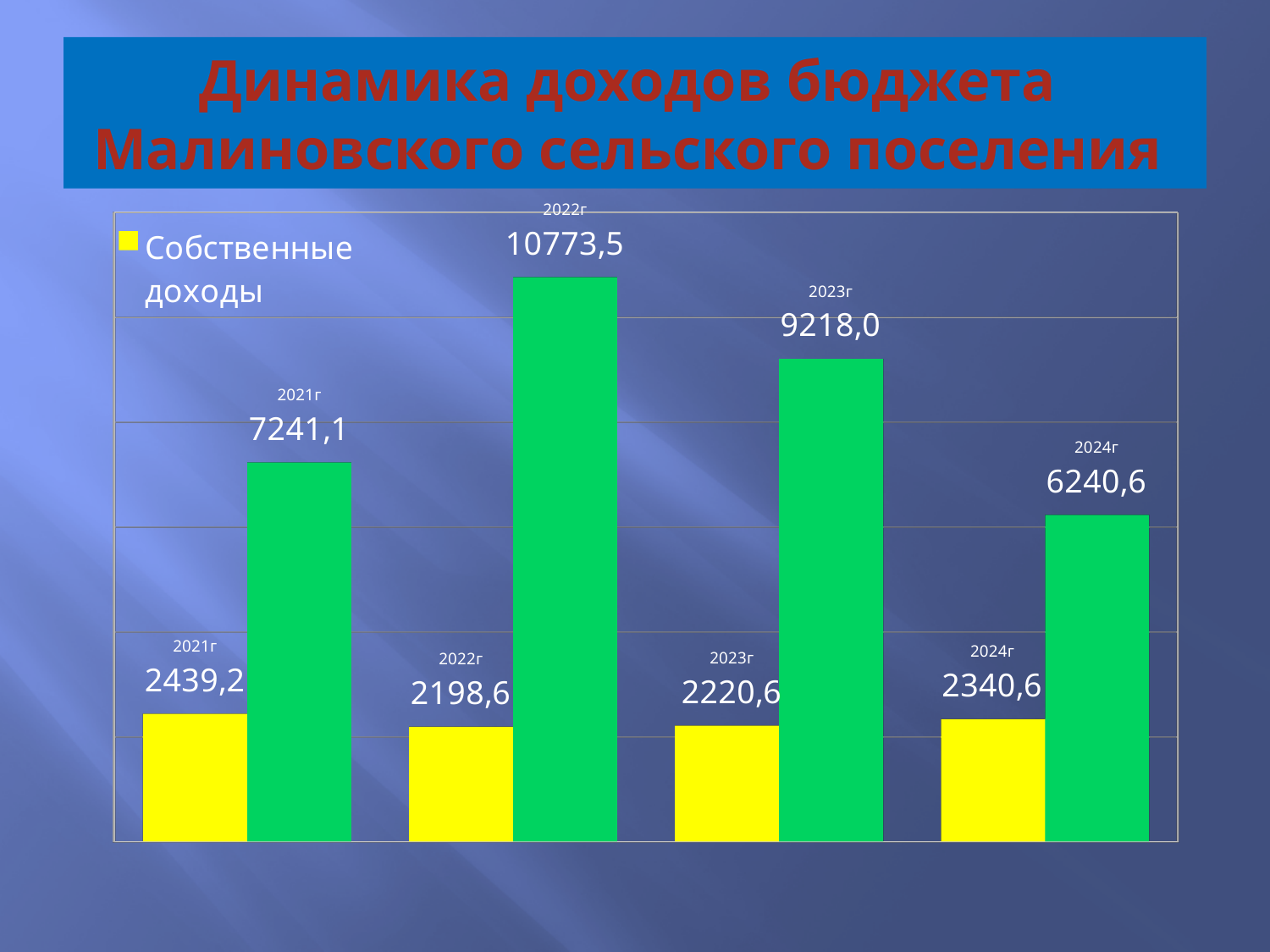
In which year is the green bar the highest? 2022г What is the value of the green bar for 2022г? 10773,5 What is the value of Собственные доходы for 2023г? 2220,6 How many years are shown on the chart? 4 What is the value of the green bar for 2024г? 6240,6 What kind of chart is shown on the slide? bar chart What is the value of Собственные доходы for 2021г? 2439,2 What is the difference between Собственные доходы in 2021г and 2024г? 98,6 In which year is the value of Собственные доходы the lowest? 2022г What is the difference between the green bar values for 2022г and 2023г? 1555,5 How many entries does the chart legend list? 1 Which year has the larger green bar, 2021г or 2024г? 2021г